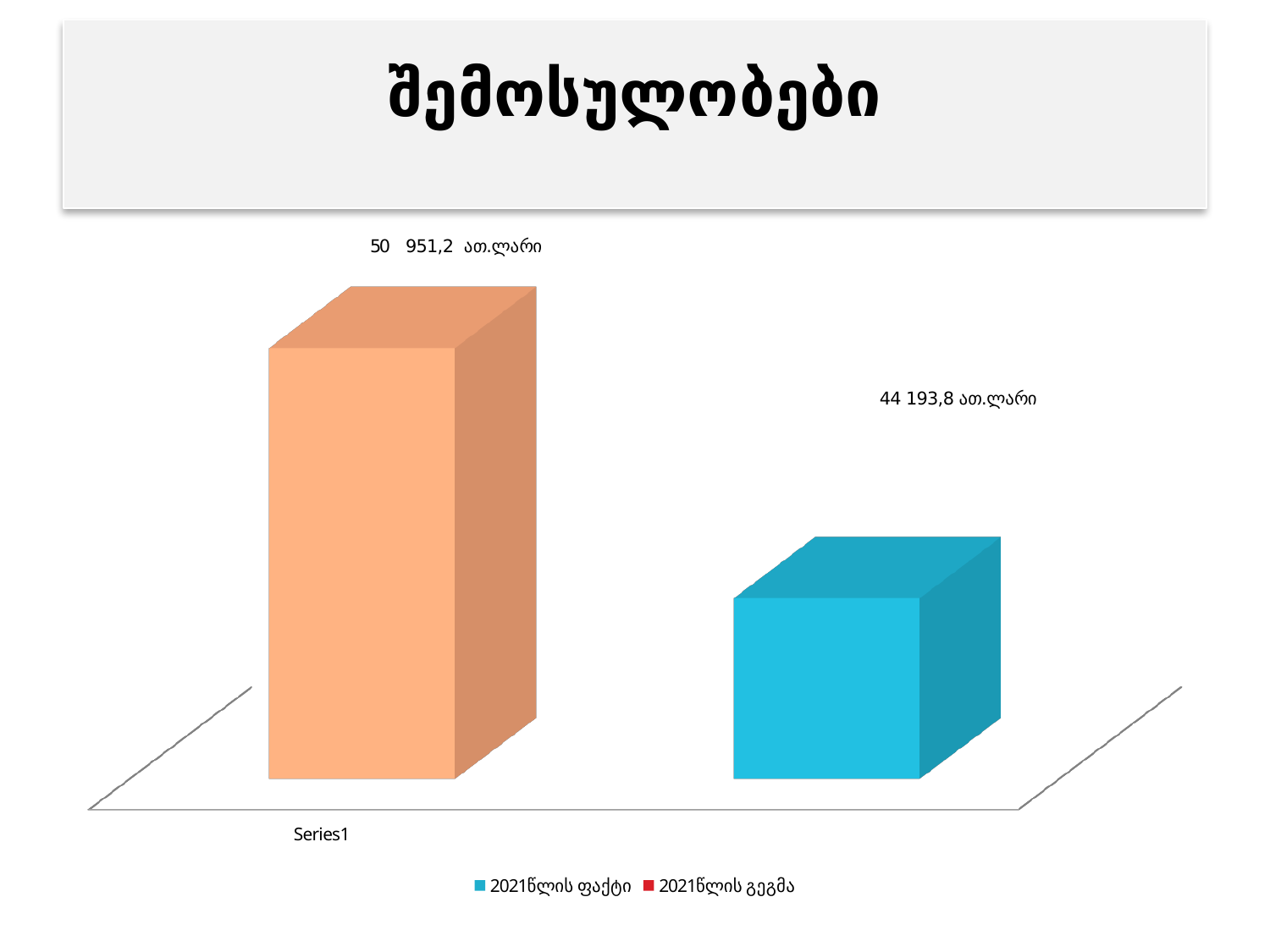
How many bars are plotted on the chart? 2 What kind of chart is shown on the slide? Bar chart What value is labelled on the orange bar? 50 951,2 ათ.ლარი Which bar is taller, the orange bar or the blue bar? The orange bar Which bar shows the highest value? The orange bar (50 951,2 ათ.ლარი) What is the category label shown on the x axis? Series1 How many series does the legend list? 2 What is the difference between the orange bar's value and the blue bar's value? 6 757,4 ათ.ლარი What is the title of the slide? შემოსულობები What value is labelled on the blue bar? 44 193,8 ათ.ლარი What are the two entries in the legend? 2021წლის ფაქტი and 2021წლის გეგმა Which bar shows the lowest value? The blue bar (44 193,8 ათ.ლარი)